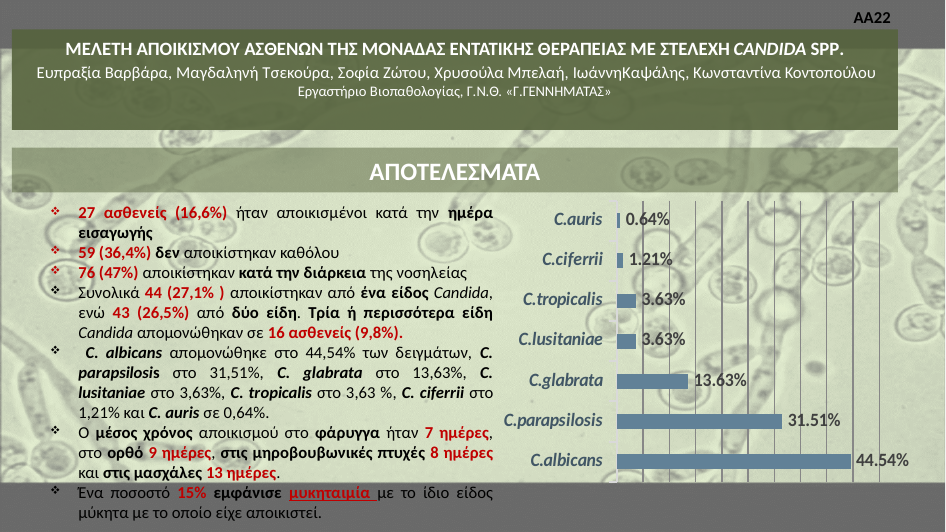
Which Candida species has the highest value in the bar chart? C.albicans What is the value shown for C.ciferrii in the bar chart? 1.21% What is the value shown for C.albicans in the bar chart? 44.54% What is the value shown for C.auris in the bar chart? 0.64% How many Candida species are shown in the bar chart? 7 What type of chart is shown on the slide? Bar chart Which two species in the bar chart share the same value of 3.63%? C.tropicalis and C.lusitaniae Which Candida species has the lowest value in the bar chart? C.auris What is the difference between the values for C.albicans and C.parapsilosis in the bar chart? 13.03% What is the value shown for C.glabrata in the bar chart? 13.63% Which has a larger value in the bar chart, C.glabrata or C.parapsilosis? C.parapsilosis What is the value shown for C.parapsilosis in the bar chart? 31.51%